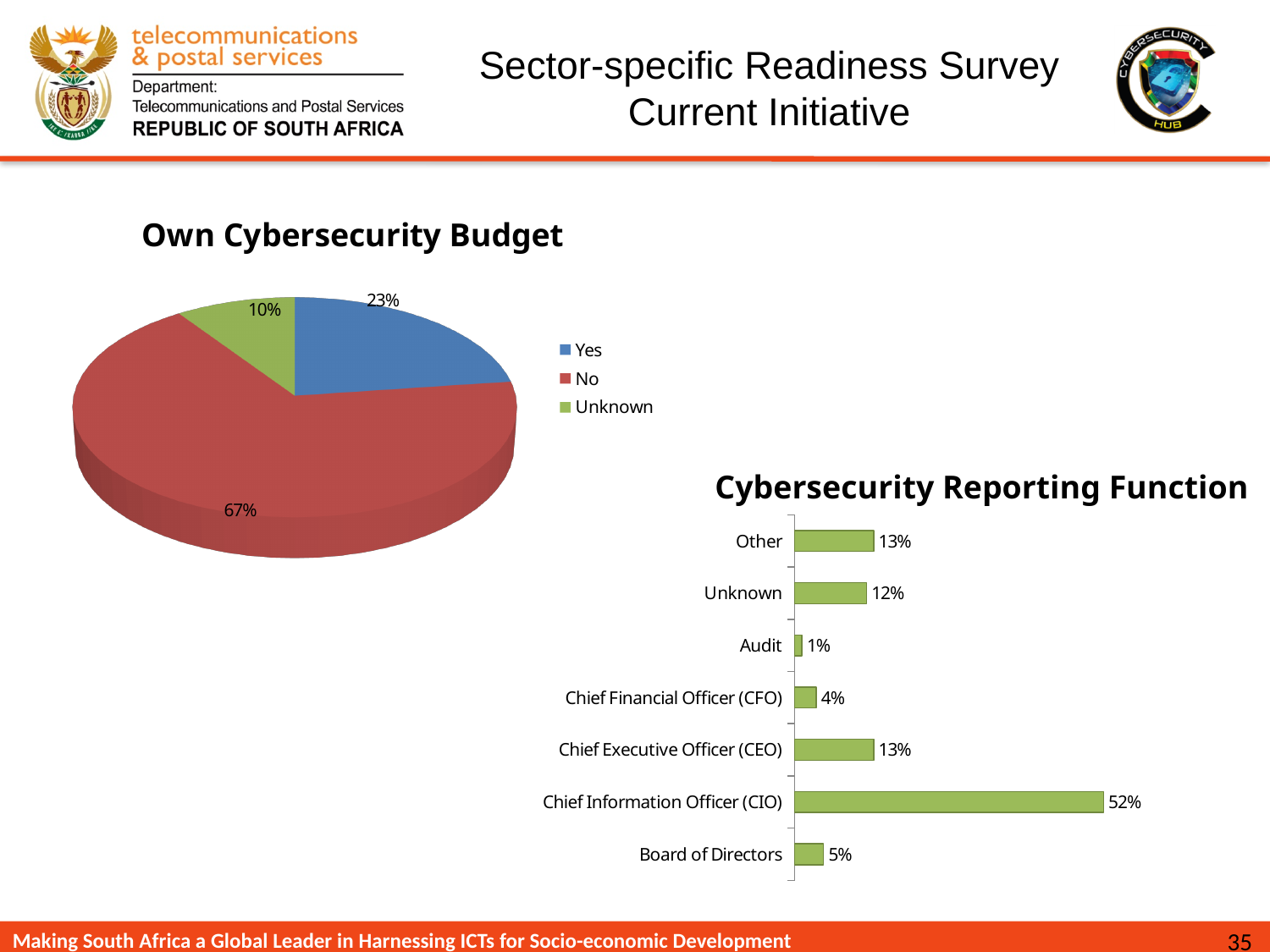
How many entries does the legend of the 'Own Cybersecurity Budget' chart list? 3 In the 'Own Cybersecurity Budget' chart, what share of respondents answered Yes? 23% In the 'Cybersecurity Reporting Function' chart, what is the value for Board of Directors? 5% In the 'Cybersecurity Reporting Function' chart, what is the value for Chief Information Officer (CIO)? 52% What kind of chart is 'Own Cybersecurity Budget'? Pie chart In the 'Own Cybersecurity Budget' chart, which category has the smallest slice? Unknown In the 'Cybersecurity Reporting Function' chart, what is the difference between the values for Chief Information Officer (CIO) and Chief Executive Officer (CEO)? 39% In the 'Own Cybersecurity Budget' chart, what share of respondents answered No? 67% In the 'Cybersecurity Reporting Function' chart, which category has the highest value? Chief Information Officer (CIO) How many categories are shown in the 'Cybersecurity Reporting Function' chart? 7 In the 'Cybersecurity Reporting Function' chart, which category has the lowest value? Audit In the 'Cybersecurity Reporting Function' chart, which is larger: the value for Unknown or the value for Chief Financial Officer (CFO)? Unknown